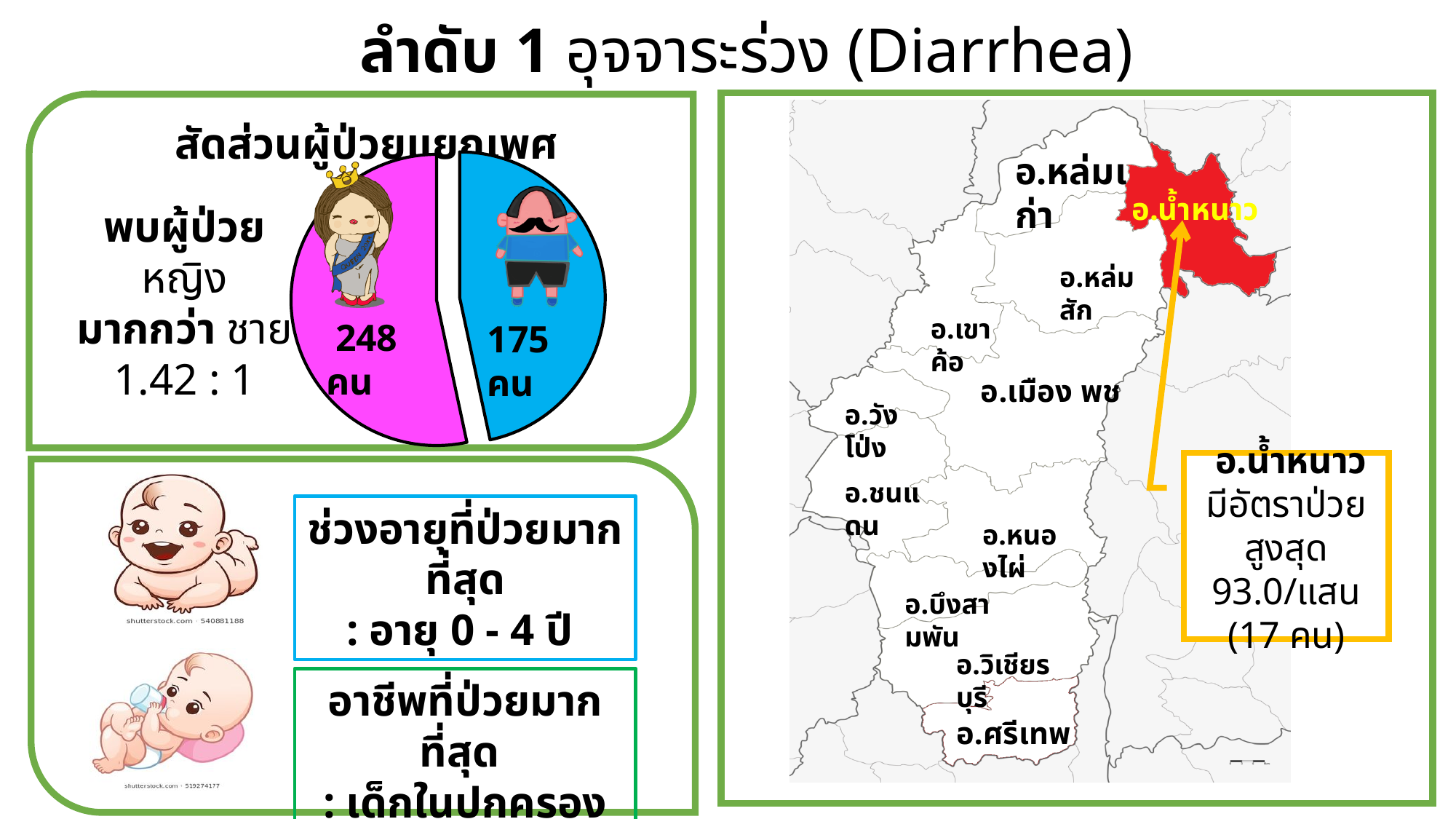
In the pie chart, how many patients are male (ชาย)? 175 คน What kind of chart is shown in the top-left panel of the slide? pie chart How many more female patients than male patients are shown in the pie chart? 73 What colour is the slice representing female patients in the pie chart? pink (magenta) What is the female-to-male ratio of patients stated next to the pie chart? 1.42 : 1 What colour is the slice representing male patients in the pie chart? blue Which group has the smallest slice in the pie chart? male (ชาย) What is the total number of patients represented by the two slices of the pie chart? 423 In the pie chart, how many patients are female (หญิง)? 248 คน How many slices does the pie chart have? 2 Which group has the larger slice in the pie chart, female or male? female (หญิง)